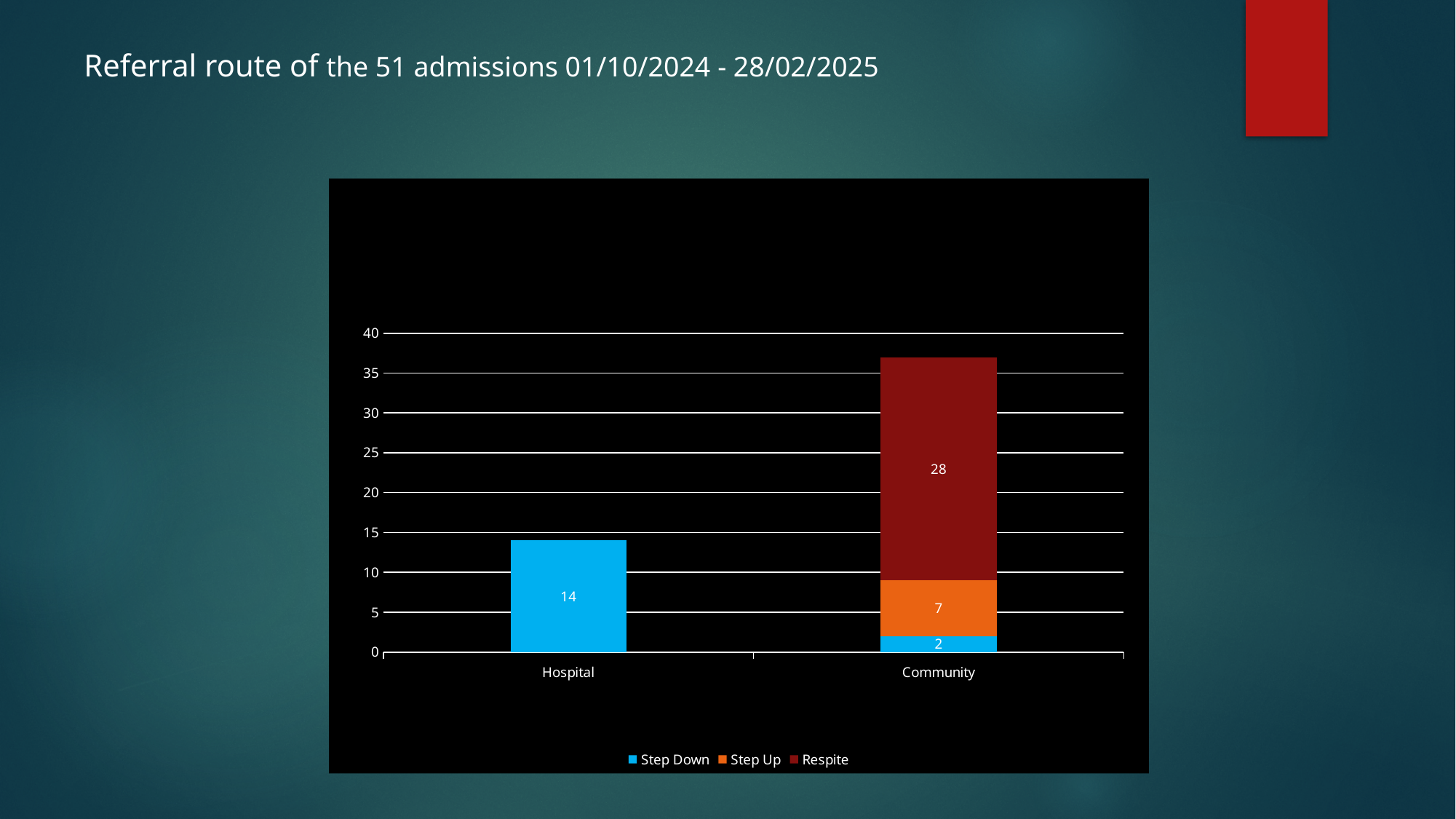
What is the Step Up value for Community? 7 What kind of chart is shown on the slide? Stacked bar chart What is the Step Down value for Community? 2 What is the difference between the Respite value for Community and the Step Down value for Hospital? 14 How many series does the legend list? 3 What is the Respite value for Community? 28 Is the total height of the Community bar greater or less than 35? greater Which is larger: the Step Down value for Hospital or the Step Down value for Community? Hospital What is the Step Down value for Hospital? 14 Which series has the highest value in the Community bar? Respite What is the total of the stacked bar for Community? 37 How many categories are shown on the x axis? 2